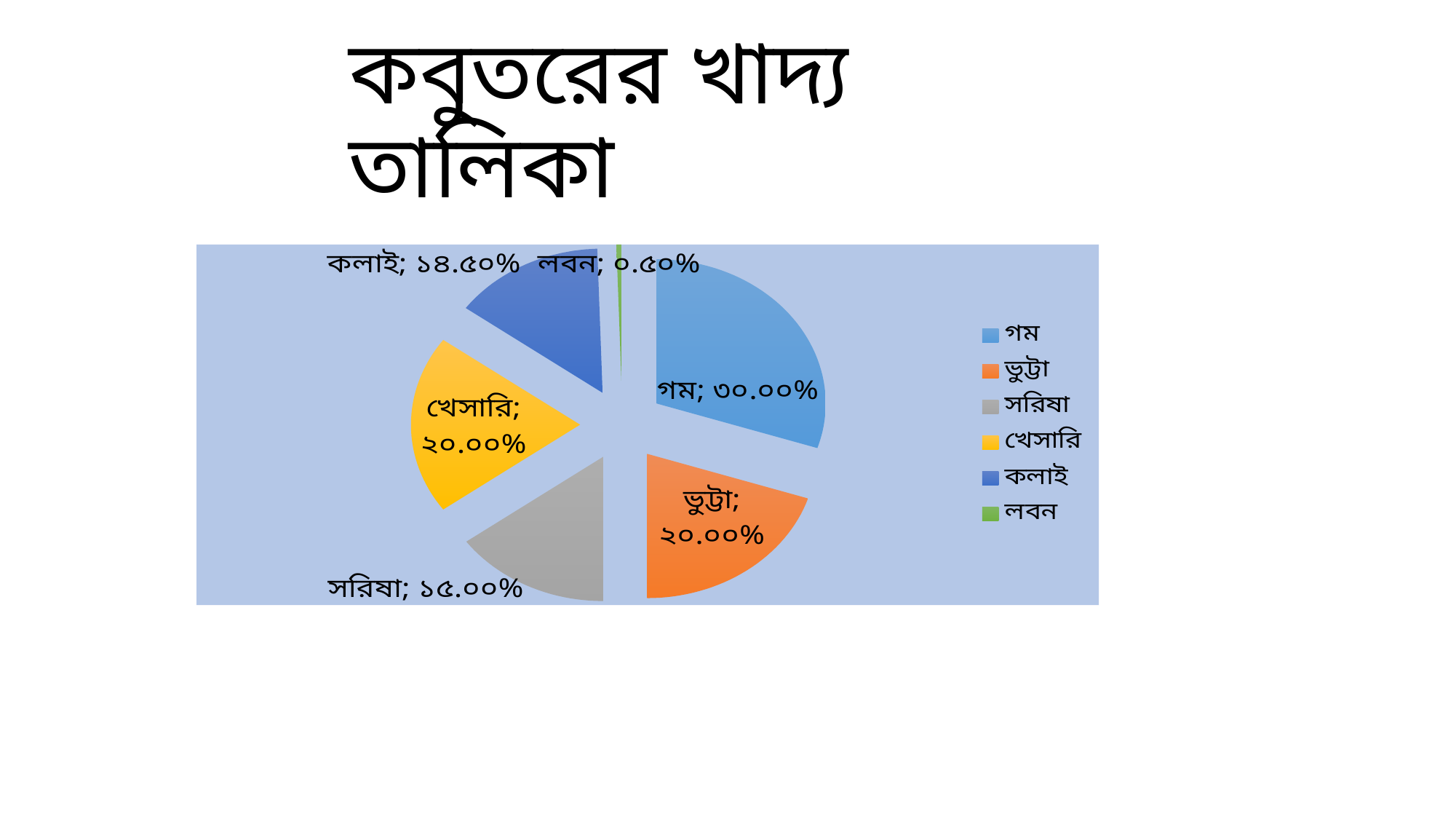
Which category has the largest slice in the pie chart? গম How many categories are shown in the pie chart? 6 What percentage does the গম slice represent in the pie chart? ৩০.০০% What percentage is shown for ভুট্টা in the pie chart? ২০.০০% What is the value labelled for সরিষা in the pie chart? ১৫.০০% What percentage is shown for কলাই in the pie chart? ১৪.৫০% What is the difference between the গম and ভুট্টা percentages in the pie chart? ১০.০০% What percentage is shown for লবন in the pie chart? ০.৫০% Which category has the smallest slice in the pie chart? লবন Which is larger in the pie chart, সরিষা or কলাই? সরিষা What kind of chart is shown on the slide? pie chart What is the title of the slide containing the pie chart? কবুতরের খাদ্য তালিকা